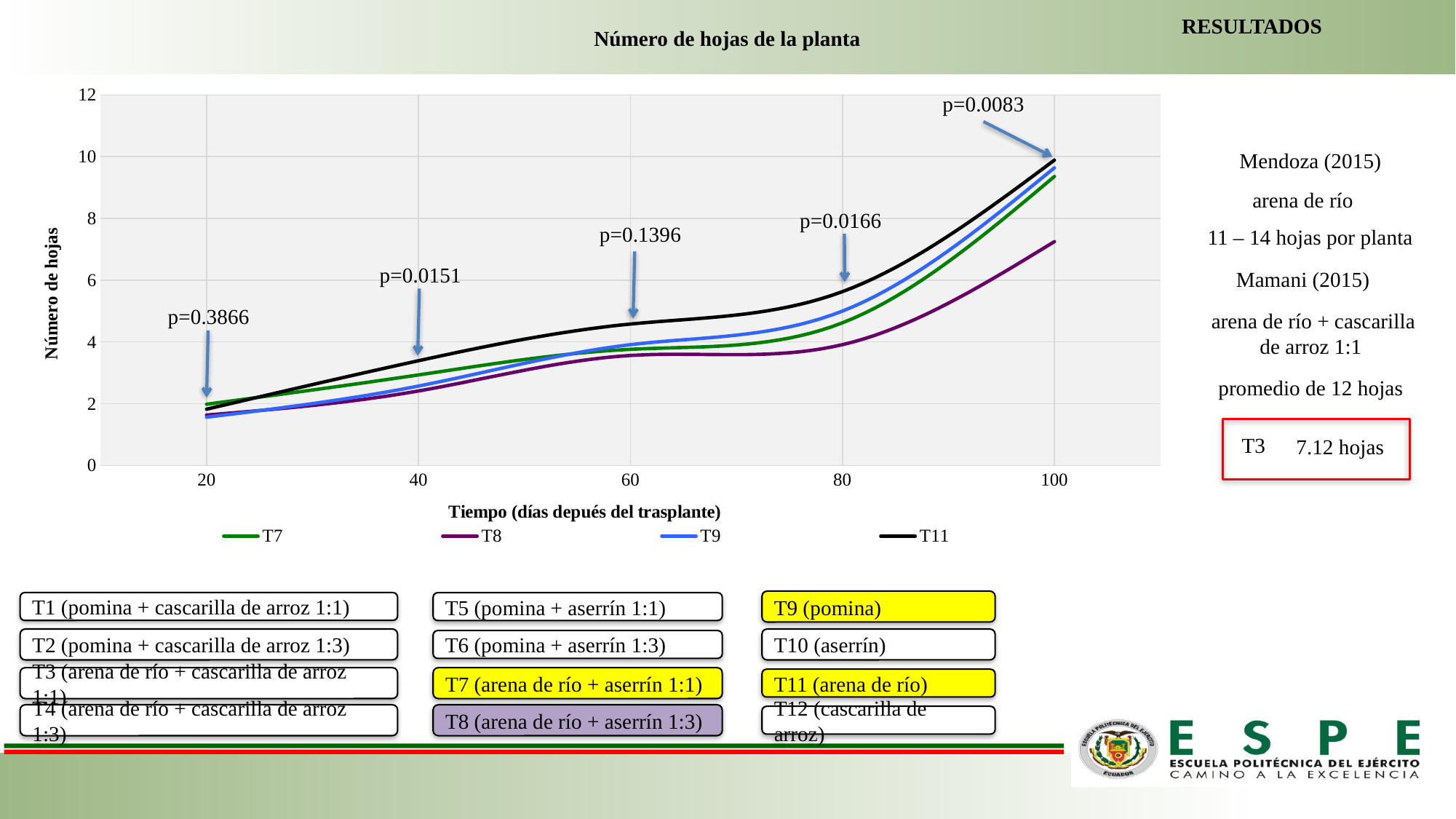
What is the title of the chart? Número de hojas de la planta How many time points are marked on the x axis of the chart? 5 At day 100, which is larger, the value for T11 or the value for T8? T11 How many series does the chart legend list? 4 Is the value for T8 at day 100 greater or less than 8? less Which series has the lowest number of leaves at day 100? T8 Is the value for T7 at day 20 greater or less than 4? less What kind of chart is shown on the slide? line chart Is the value for T11 at day 100 greater or less than 8? greater Which series has the highest number of leaves at day 80? T11 What p-value is annotated at day 100 on the chart? p=0.0083 Do the values for T11 rise or fall as time increases along the x axis? rise